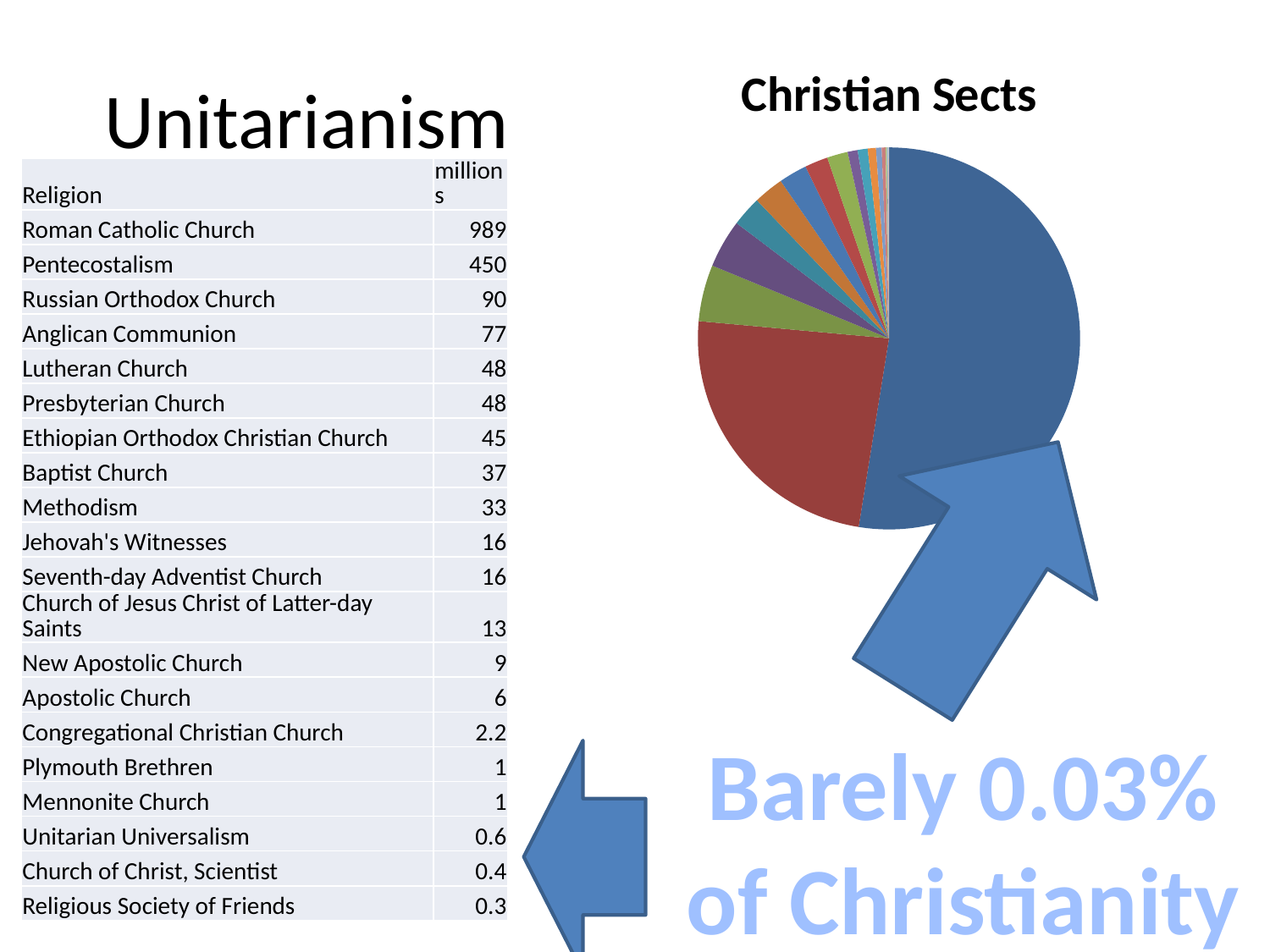
In the "Christian Sects" pie chart, which of the two largest slices is bigger: the blue slice or the red slice? the blue slice What kind of chart is shown under the title "Christian Sects"? pie chart Based on the table of values plotted in the "Christian Sects" pie chart, what value (in millions) is given for Pentecostalism? 450 Based on the table of values plotted in the "Christian Sects" pie chart, is the value for the Russian Orthodox Church larger or smaller than the value for the Anglican Communion? larger Based on the table of values plotted in the "Christian Sects" pie chart, what value (in millions) is given for Unitarian Universalism? 0.6 Based on the table of values plotted in the "Christian Sects" pie chart, which religion has the smallest value? Religious Society of Friends Does the "Christian Sects" pie chart display a legend or data labels on its slices? No Based on the table of values plotted in the "Christian Sects" pie chart, which religion has the largest value? Roman Catholic Church What is the title of the pie chart on the slide? Christian Sects Based on the table of values plotted in the "Christian Sects" pie chart, what is the difference in millions between the Roman Catholic Church and Pentecostalism? 539